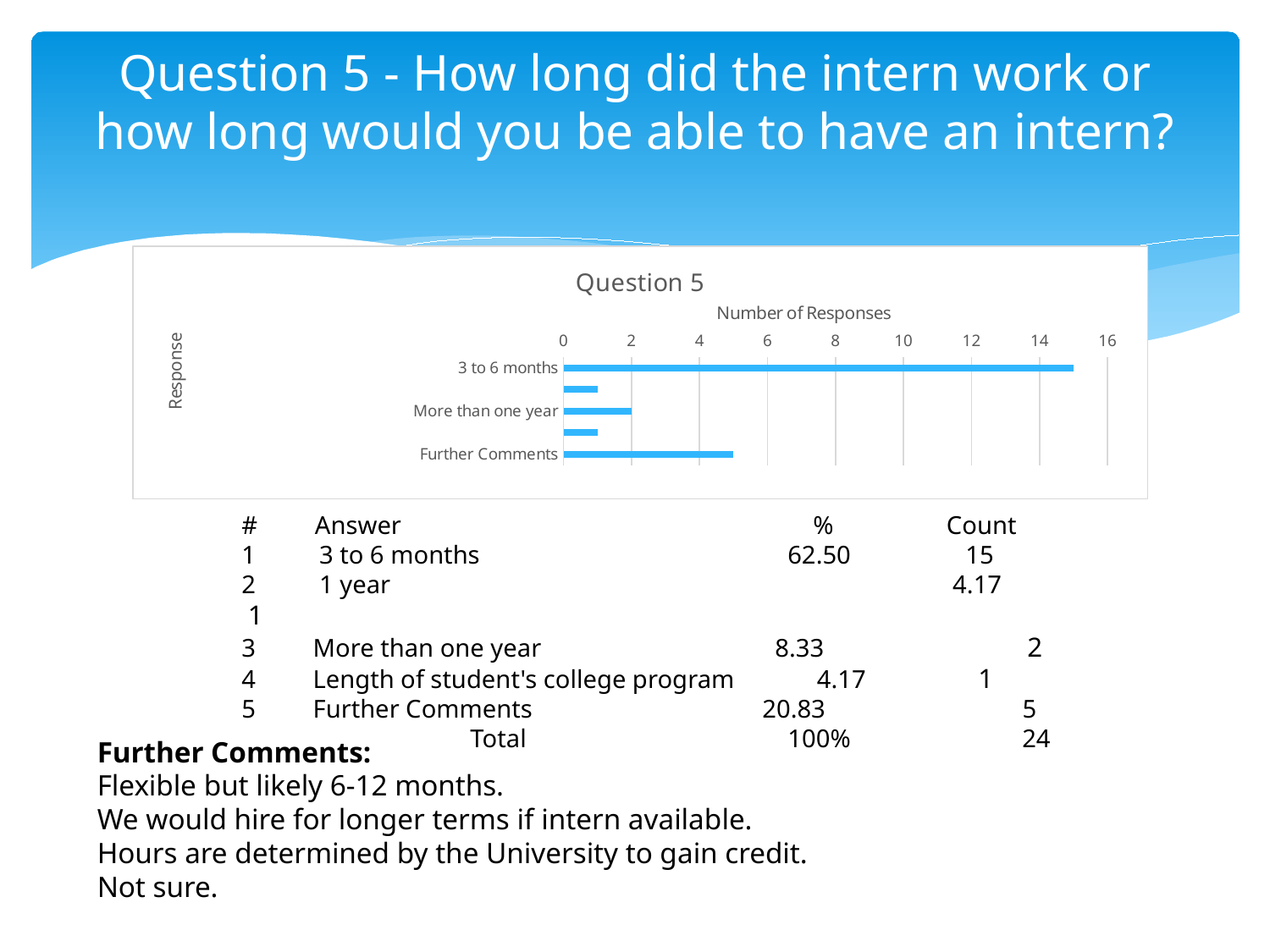
Which has more responses, '3 to 6 months' or 'Further Comments'? 3 to 6 months How many more responses does '3 to 6 months' have than 'Further Comments'? 10 What is the number of responses for 'More than one year'? 2 Which response category has the highest number of responses? 3 to 6 months What is the title of the horizontal axis of the chart? Number of Responses What is the number of responses for '3 to 6 months'? 15 Which has more responses, 'More than one year' or 'Further Comments'? Further Comments What is the number of responses for 'Further Comments'? 5 Is the value for '3 to 6 months' greater or less than 14? greater Is the value for 'Further Comments' greater or less than 4? greater How many bars are plotted in the chart? 5 What kind of chart is shown on the slide? bar chart